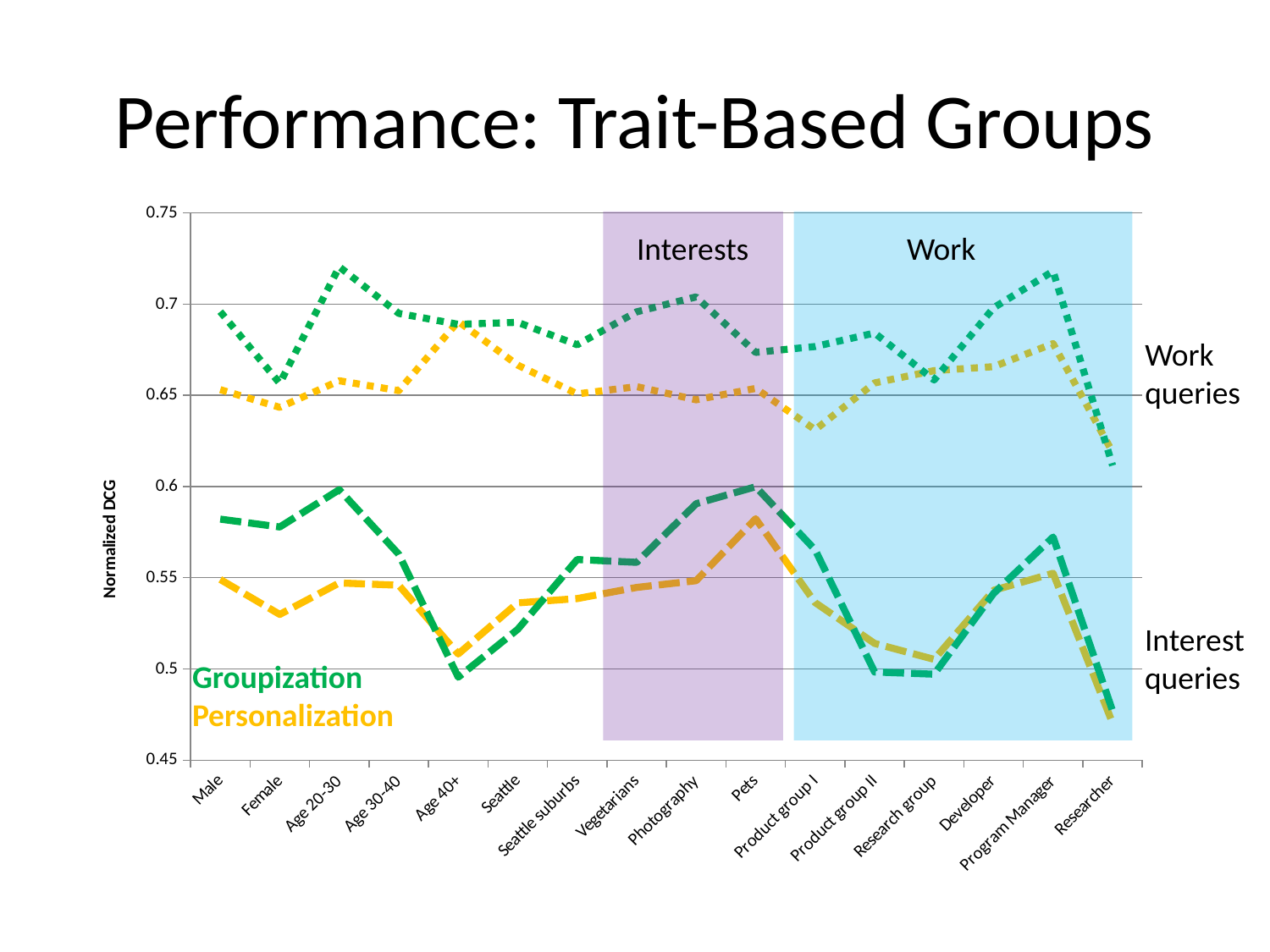
Do the Work queries Groupization values rise or fall from Program Manager to Researcher? fall For Interest queries, which group has the lowest Personalization value? Researcher Is the Personalization value for Work queries for Product group I greater or less than 0.65? less What kind of chart is shown on the slide? line chart Is the Groupization value for Work queries for Age 20-30 greater or less than 0.7? greater What is the label of the y axis? Normalized DCG What are the two shaded regions on the chart labelled? Interests and Work How many trait-based groups are listed along the x axis? 16 Is the Groupization value for Interest queries for Researcher greater or less than 0.5? less For Work queries, which group has the lowest Groupization value? Researcher For Work queries on the Male group, which is higher: Groupization or Personalization? Groupization